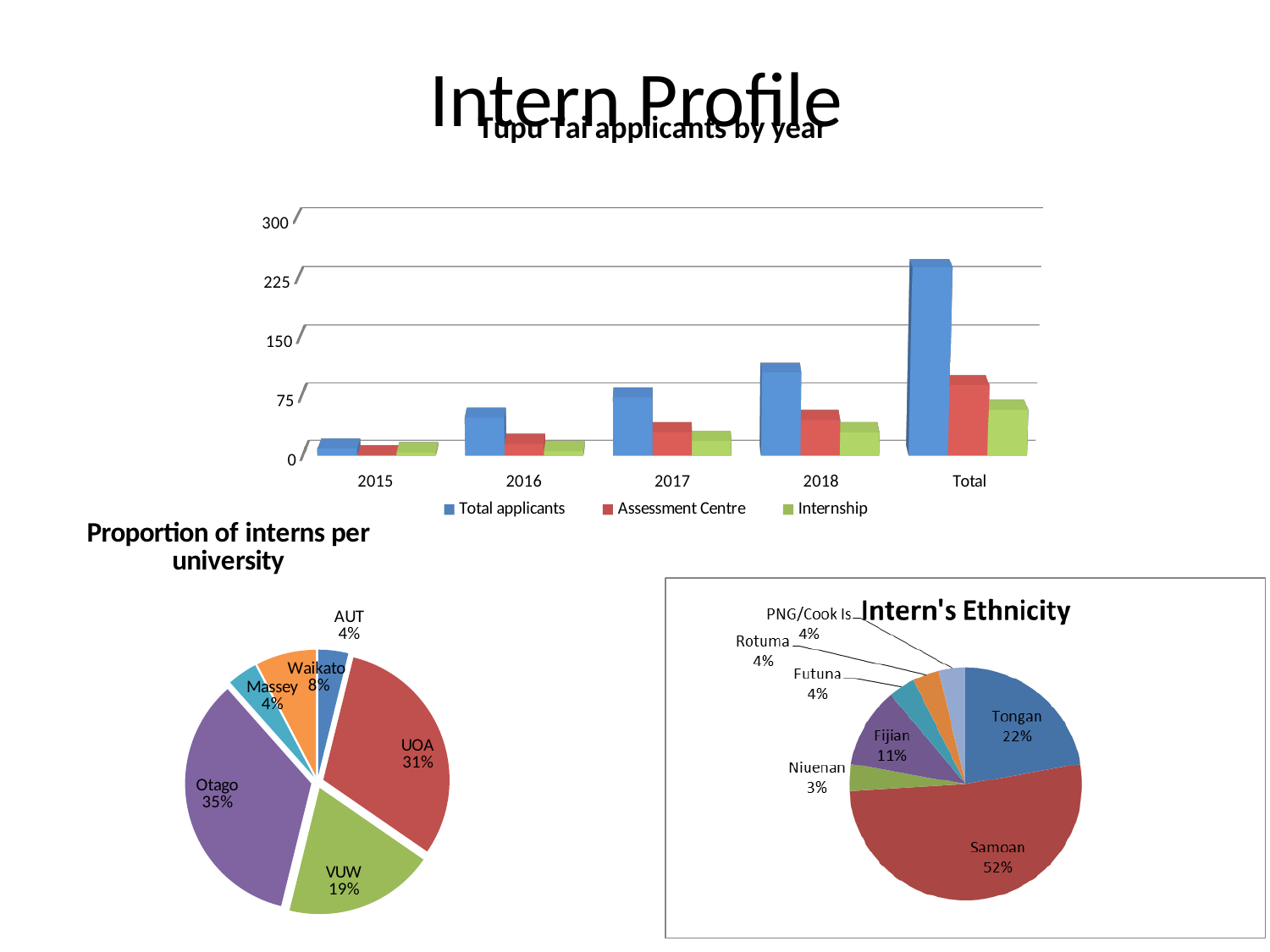
In the 'Intern's Ethnicity' pie chart, which ethnicity has the smallest share? Niuenan In the 'Tupu Tai applicants by year' chart, what kind of chart is it? bar chart In the 'Proportion of interns per university' pie chart, what is the difference between the UOA and VUW shares? 12% In the 'Proportion of interns per university' pie chart, which university has the largest share? Otago In the 'Tupu Tai applicants by year' chart, how many series does the legend list? 3 In the 'Tupu Tai applicants by year' chart, do the Total applicants values rise or fall from 2015 to 2018? rise In the 'Tupu Tai applicants by year' chart, how many categories are shown on the x axis? 5 In the 'Intern's Ethnicity' pie chart, how many slices are there? 7 In the 'Tupu Tai applicants by year' chart, is the Total applicants value for 2015 greater or less than 75? less In the 'Proportion of interns per university' pie chart, what share does Otago have? 35% In the 'Tupu Tai applicants by year' chart, is the Total applicants value for Total greater or less than 225? greater In the 'Intern's Ethnicity' pie chart, what share is Samoan? 52%